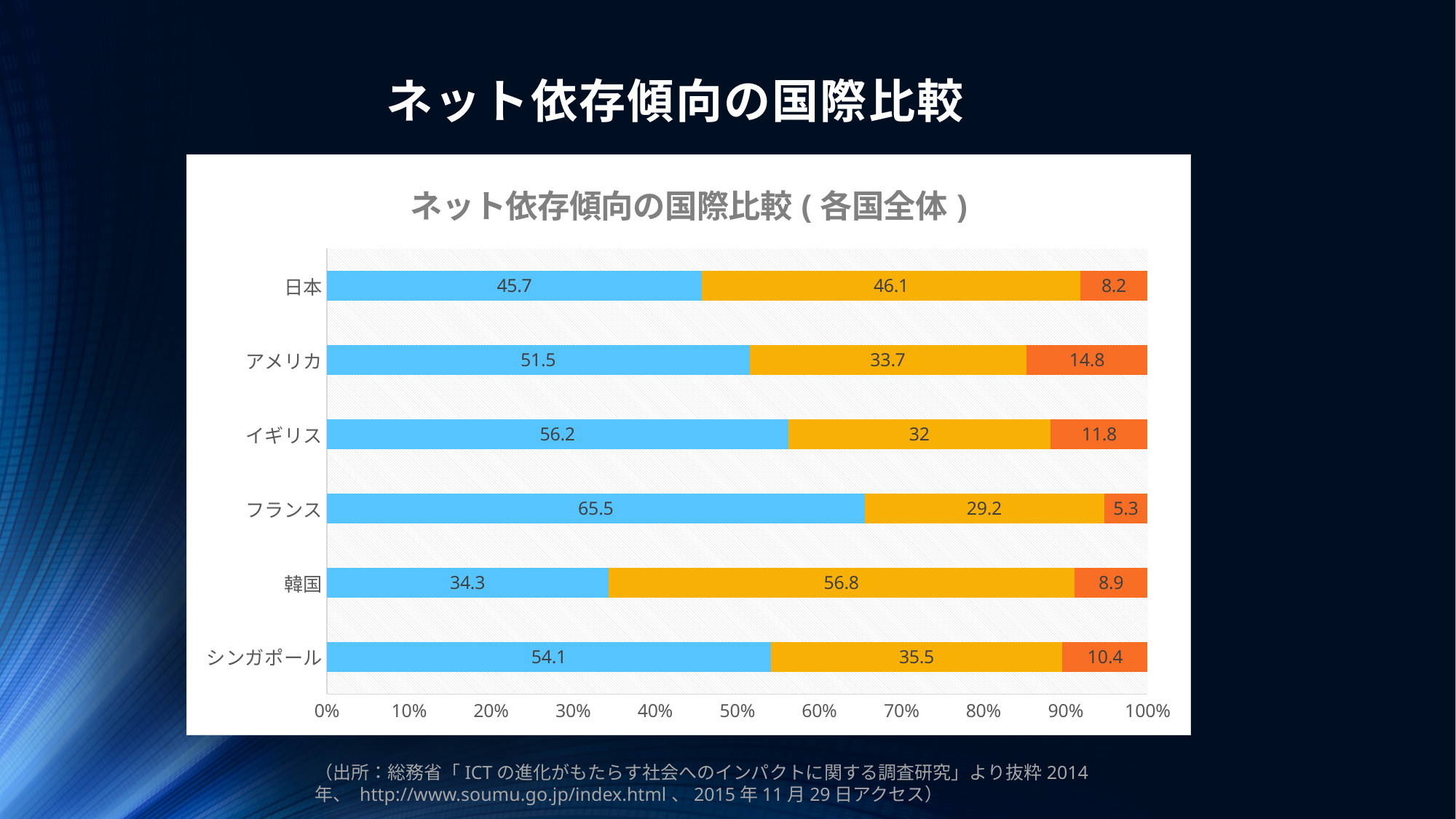
Which country has the smallest dark orange (right) segment? フランス What is the value of the middle (orange) segment for 韓国? 56.8 What type of chart is shown on the slide? Stacked bar chart What is the title of the chart? ネット依存傾向の国際比較 ( 各国全体 ) What is the value of the blue (left) segment for 日本? 45.7 What is the difference between the middle (orange) segment and the blue (left) segment for 日本? 0.4 Which is larger: the blue (left) segment for イギリス or the blue (left) segment for アメリカ? イギリス What is the value of the dark orange (right) segment for アメリカ? 14.8 Which country has the largest blue (left) segment? フランス How many countries are shown in the chart? 6 Which country has the smallest blue (left) segment? 韓国 What is the value of the blue (left) segment for シンガポール? 54.1